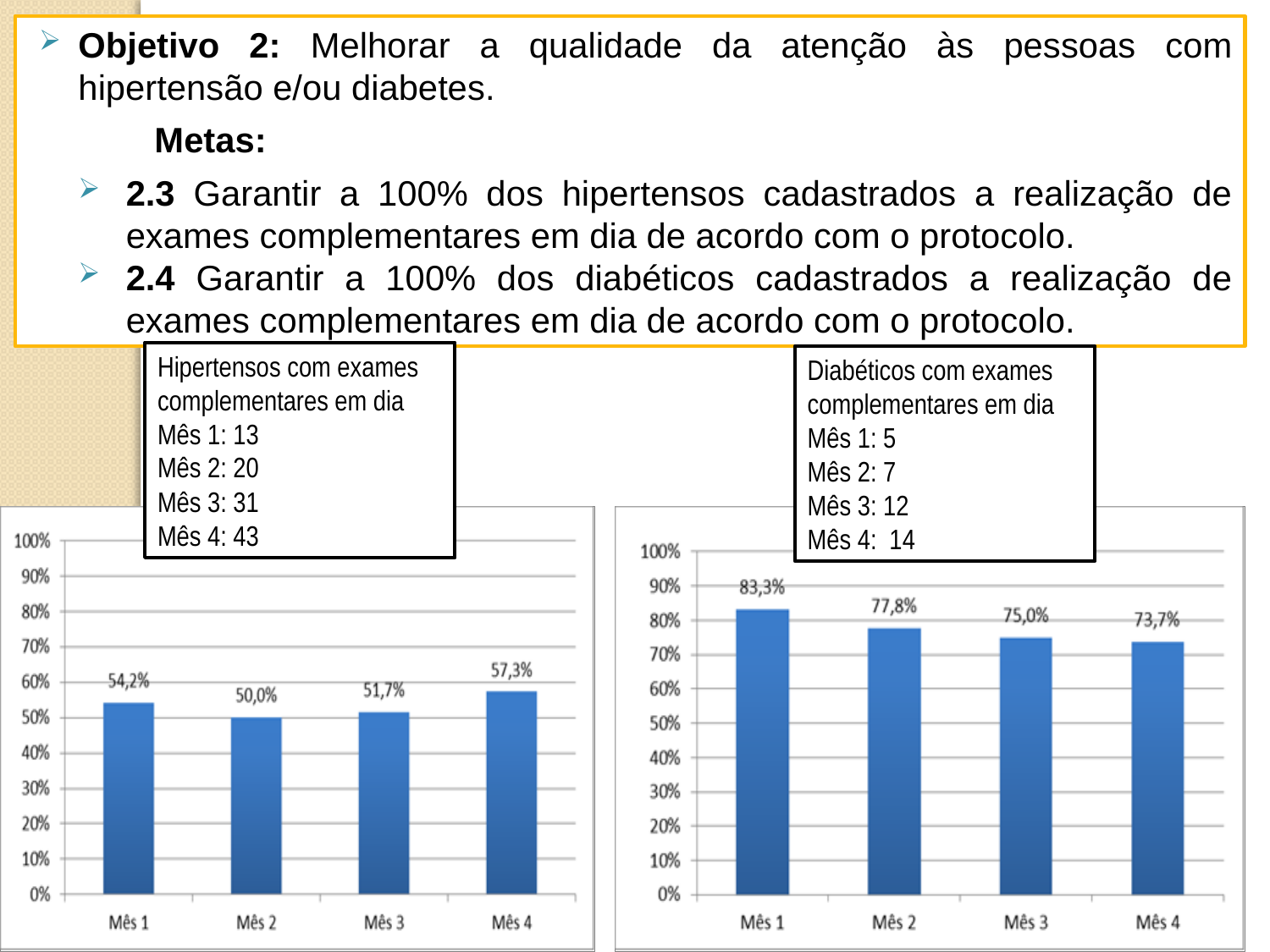
In the right chart (Diabéticos com exames complementares em dia), what is the value for Mês 2? 77,8% In the right chart (Diabéticos com exames complementares em dia), what is the value for Mês 4? 73,7% How many months are shown on the x axis of the left chart (Hipertensos com exames complementares em dia)? 4 What kind of chart is the right chart (Diabéticos com exames complementares em dia)? bar chart In the left chart (Hipertensos com exames complementares em dia), what is the value for Mês 1? 54,2% In the right chart (Diabéticos com exames complementares em dia), what is the difference between the values for Mês 1 and Mês 4? 9,6% In the left chart (Hipertensos com exames complementares em dia), what is the value for Mês 4? 57,3% In the right chart (Diabéticos com exames complementares em dia), is the value for Mês 3 greater or less than 80%? less In the left chart (Hipertensos com exames complementares em dia), which is larger, the value for Mês 1 or the value for Mês 3? Mês 1 In the left chart (Hipertensos com exames complementares em dia), which month has the lowest value? Mês 2 In the right chart (Diabéticos com exames complementares em dia), which month has the highest value? Mês 1 In the right chart (Diabéticos com exames complementares em dia), do the values rise or fall from Mês 1 to Mês 4? fall